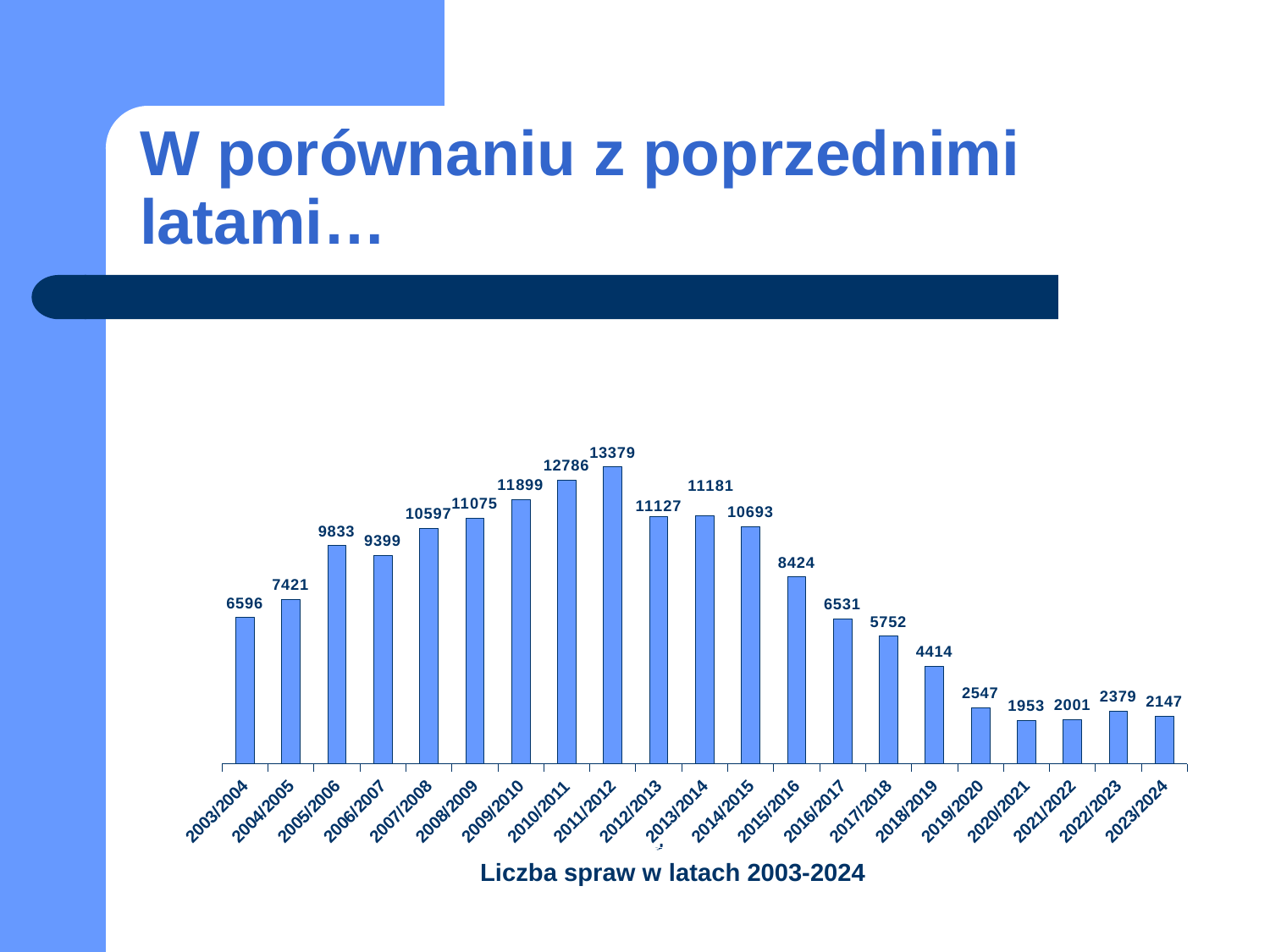
What is the difference between the values for 2022/2023 and 2023/2024? 232 Which is larger, the value for 2005/2006 or the value for 2006/2007? 2005/2006 Which year has the lowest value? 2020/2021 What is the value for 2003/2004? 6596 What is the title of the chart? Liczba spraw w latach 2003-2024 Which year has the highest value? 2011/2012 What is the difference between the values for 2011/2012 and 2003/2004? 6783 What is the value for 2011/2012? 13379 What is the value for 2018/2019? 4414 Which is larger, the value for 2015/2016 or the value for 2016/2017? 2015/2016 How many years are shown on the x axis? 21 What kind of chart is shown on the slide? bar chart